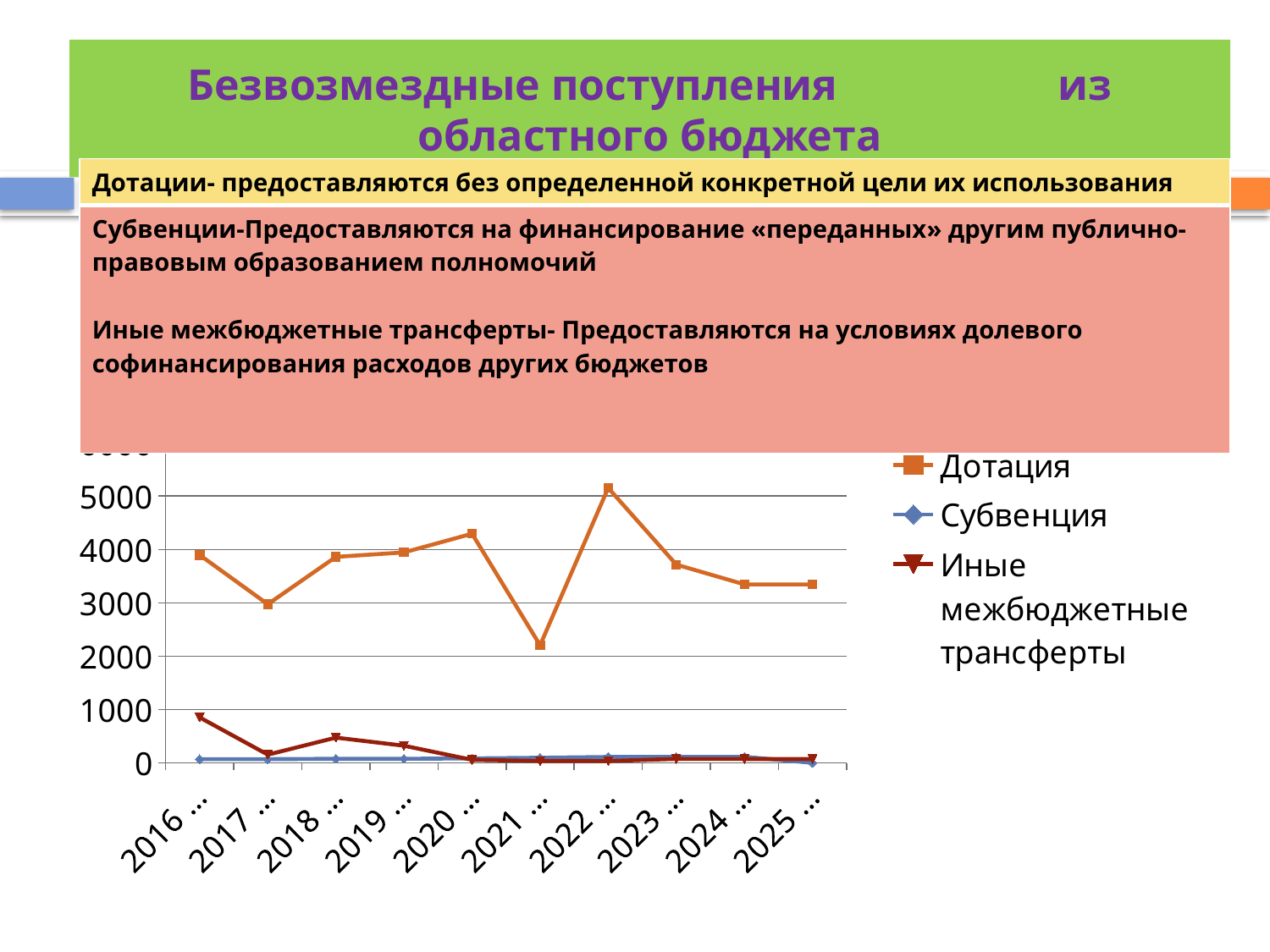
Is the value of Дотация in 2021 greater or less than 3000? less Is the value of Иные межбюджетные трансферты in 2016 greater or less than 1000? less Which series is drawn in orange on the chart? Дотация In which year does the Дотация series reach its highest value? 2022 In which year does the Иные межбюджетные трансферты series reach its highest value? 2016 Does the Дотация series rise or fall from 2022 to 2025? fall What kind of chart is shown on the slide? line chart Which is larger for the Дотация series: the value in 2021 or the value in 2022? 2022 In which year does the Дотация series reach its lowest value? 2021 How many series does the chart legend list? 3 How many years are plotted along the x axis of the chart? 10 Is the value of Дотация in 2022 greater or less than 5000? greater